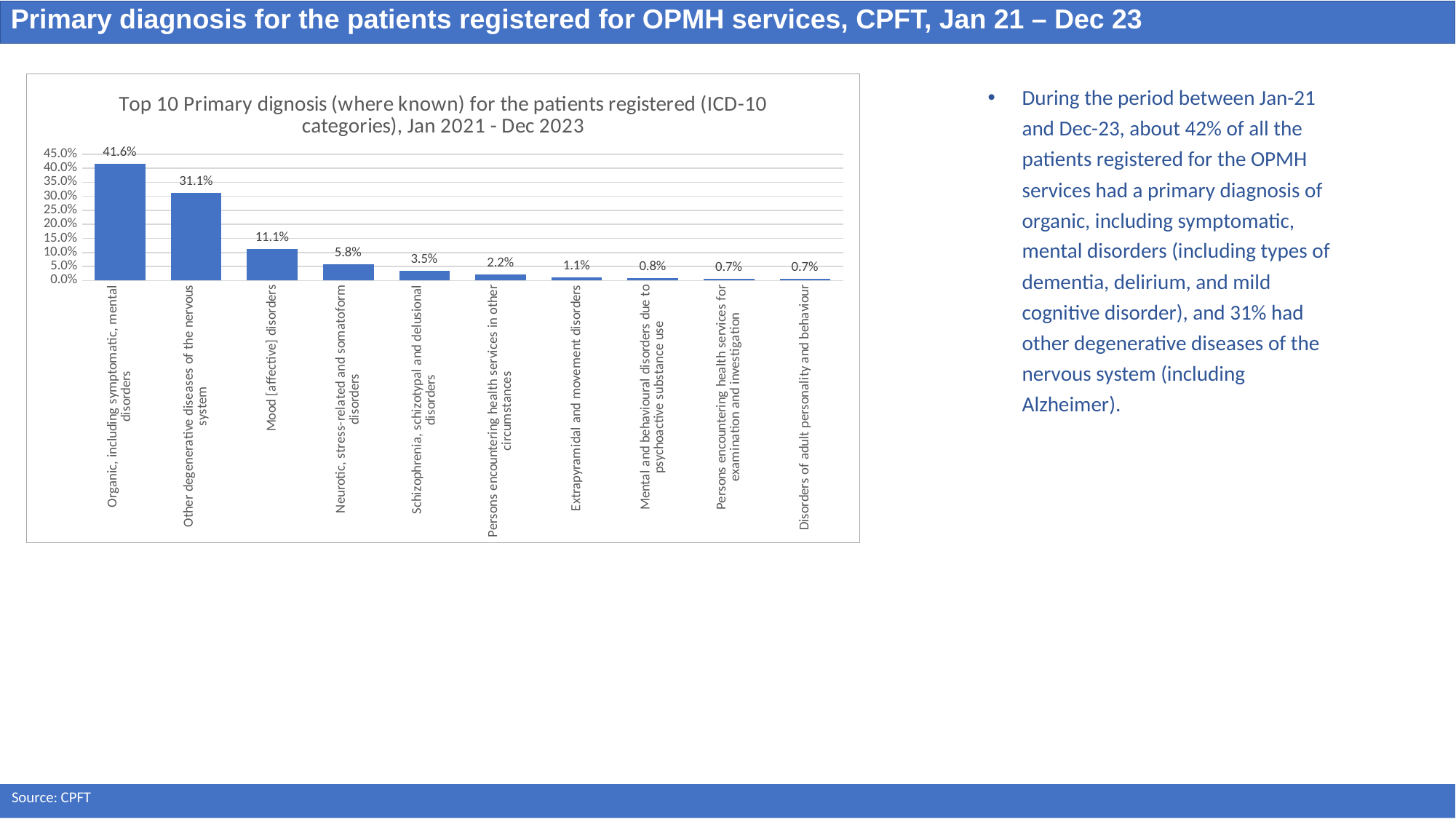
Which is larger: the value for Schizophrenia, schizotypal and delusional disorders or the value for Persons encountering health services in other circumstances? Schizophrenia, schizotypal and delusional disorders How many diagnosis categories are shown in the chart? 10 What type of chart is shown on the slide? Bar chart What is the title of the chart? Top 10 Primary dignosis (where known) for the patients registered (ICD-10 categories), Jan 2021 - Dec 2023 What is the value shown for Extrapyramidal and movement disorders? 1.1% Is the value for Other degenerative diseases of the nervous system greater or less than 30.0%? greater What is the value shown for Neurotic, stress-related and somatoform disorders? 5.8% What is the difference between the values for Organic, including symptomatic, mental disorders and Other degenerative diseases of the nervous system? 10.5% What is the value shown for Mood [affective] disorders? 11.1% Do the values rise or fall moving from left to right along the x axis? Fall What percentage of patients had a primary diagnosis of Organic, including symptomatic, mental disorders? 41.6% Which diagnosis category has the highest value in the chart? Organic, including symptomatic, mental disorders